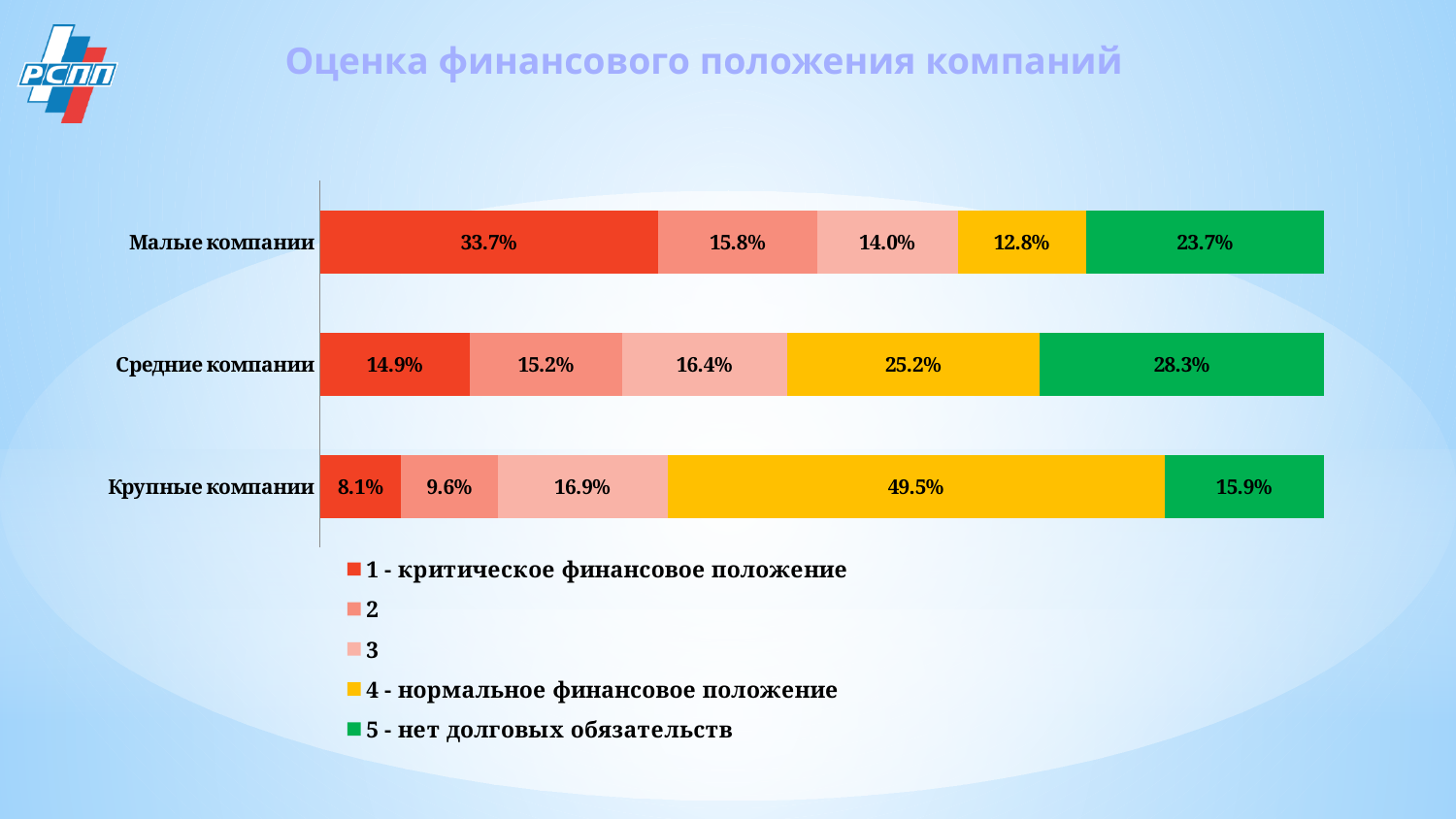
What is the difference between the "4 - нормальное финансовое положение" shares of Крупные компании and Средние компании? 24.3% What share of Малые компании falls in category "1 - критическое финансовое положение"? 33.7% What is the total of the stacked bar for Крупные компании? 100.0% Which is larger: the "5 - нет долговых обязательств" share for Малые компании or for Крупные компании? Малые компании How many company groups are shown in the chart? 3 What type of chart is shown on the slide? Stacked bar chart How many series does the legend list? 5 Which company group has the highest share in category "1 - критическое финансовое положение"? Малые компании What share of Крупные компании falls in category "4 - нормальное финансовое положение"? 49.5% What is the title of the slide? Оценка финансового положения компаний What share of Средние компании falls in category "5 - нет долговых обязательств"? 28.3% Which company group has the lowest share in category "4 - нормальное финансовое положение"? Малые компании